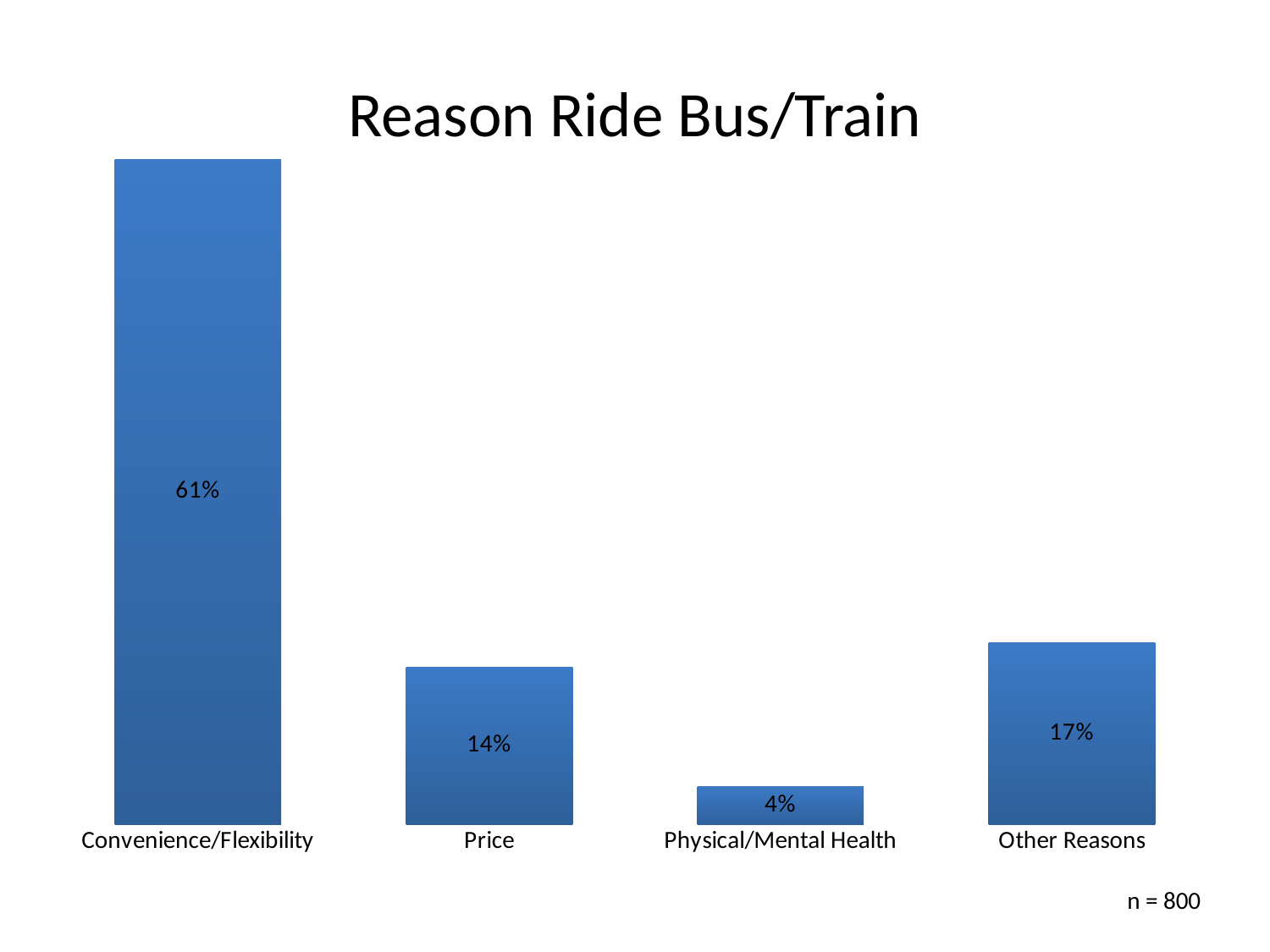
Which category has the highest value? Convenience/Flexibility Which is larger, the value for Price or the value for Other Reasons? Other Reasons What is the difference between the values for Other Reasons and Price? 3% What is the value for Price? 14% What is the value for Physical/Mental Health? 4% What is the difference between the values for Convenience/Flexibility and Other Reasons? 44% What kind of chart is shown on the slide? Bar chart What is the value for Other Reasons? 17% What is the title of the chart? Reason Ride Bus/Train Which category has the lowest value? Physical/Mental Health How many categories are shown in the chart? 4 What is the value for Convenience/Flexibility? 61%